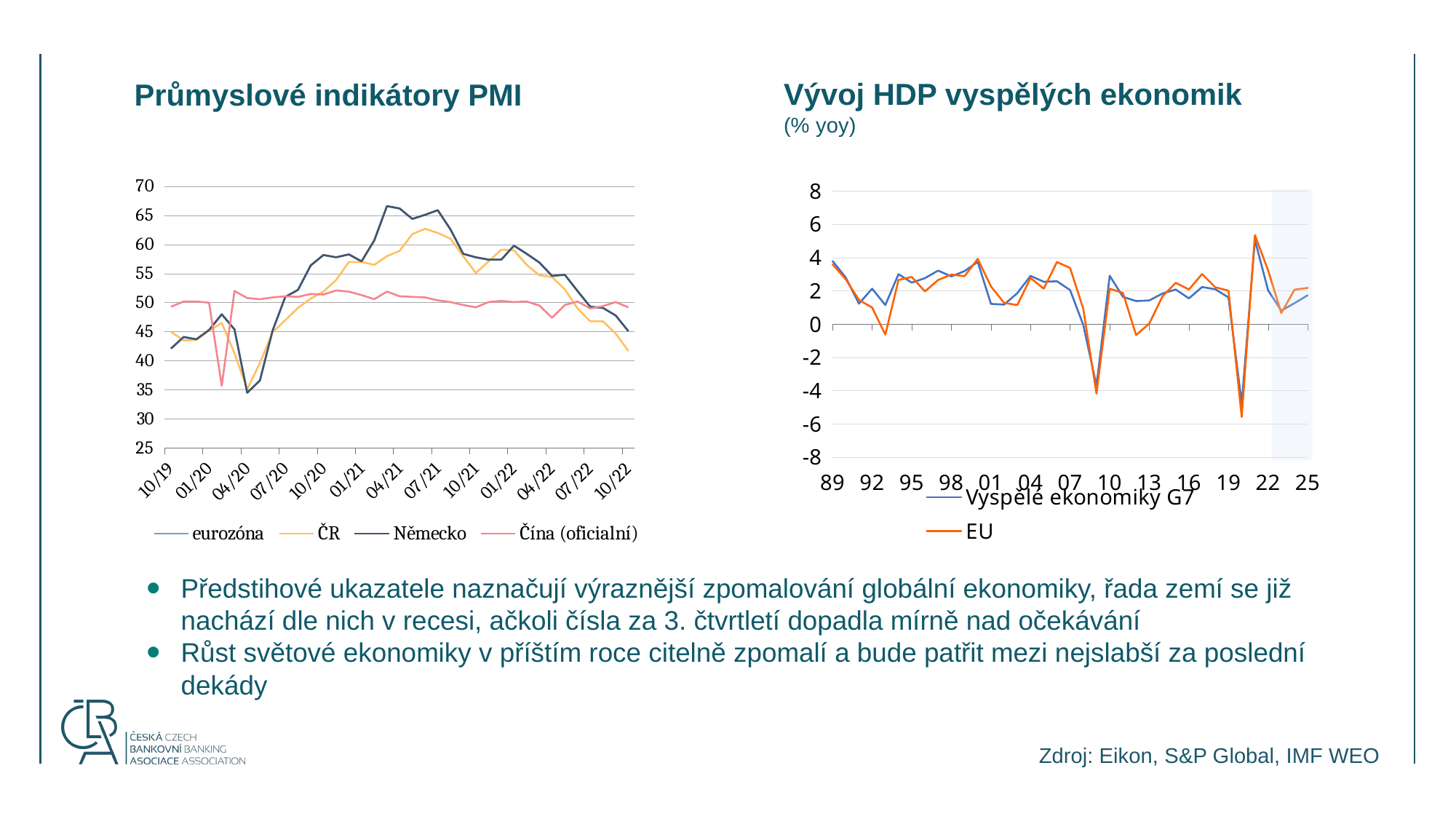
In the 'Průmyslové indikátory PMI' chart, is the value for ČR at 10/22 greater or less than 45? less What kind of chart is the 'Průmyslové indikátory PMI' chart? line chart Which series in the 'Vývoj HDP vyspělých ekonomik' chart is drawn in orange? EU In the 'Průmyslové indikátory PMI' chart, is the value for Německo at 04/20 greater or less than 40? less How many series does the legend of the 'Průmyslové indikátory PMI' chart list? 4 In the 'Vývoj HDP vyspělých ekonomik' chart, is the value for EU in 2021 greater or less than 4? greater What kind of chart is the 'Vývoj HDP vyspělých ekonomik' chart? line chart In the 'Průmyslové indikátory PMI' chart, does the Německo series rise or fall between 04/21 and 10/22? fall How many series does the legend of the 'Vývoj HDP vyspělých ekonomik' chart list? 2 What unit is shown in the subtitle of the 'Vývoj HDP vyspělých ekonomik' chart? % yoy